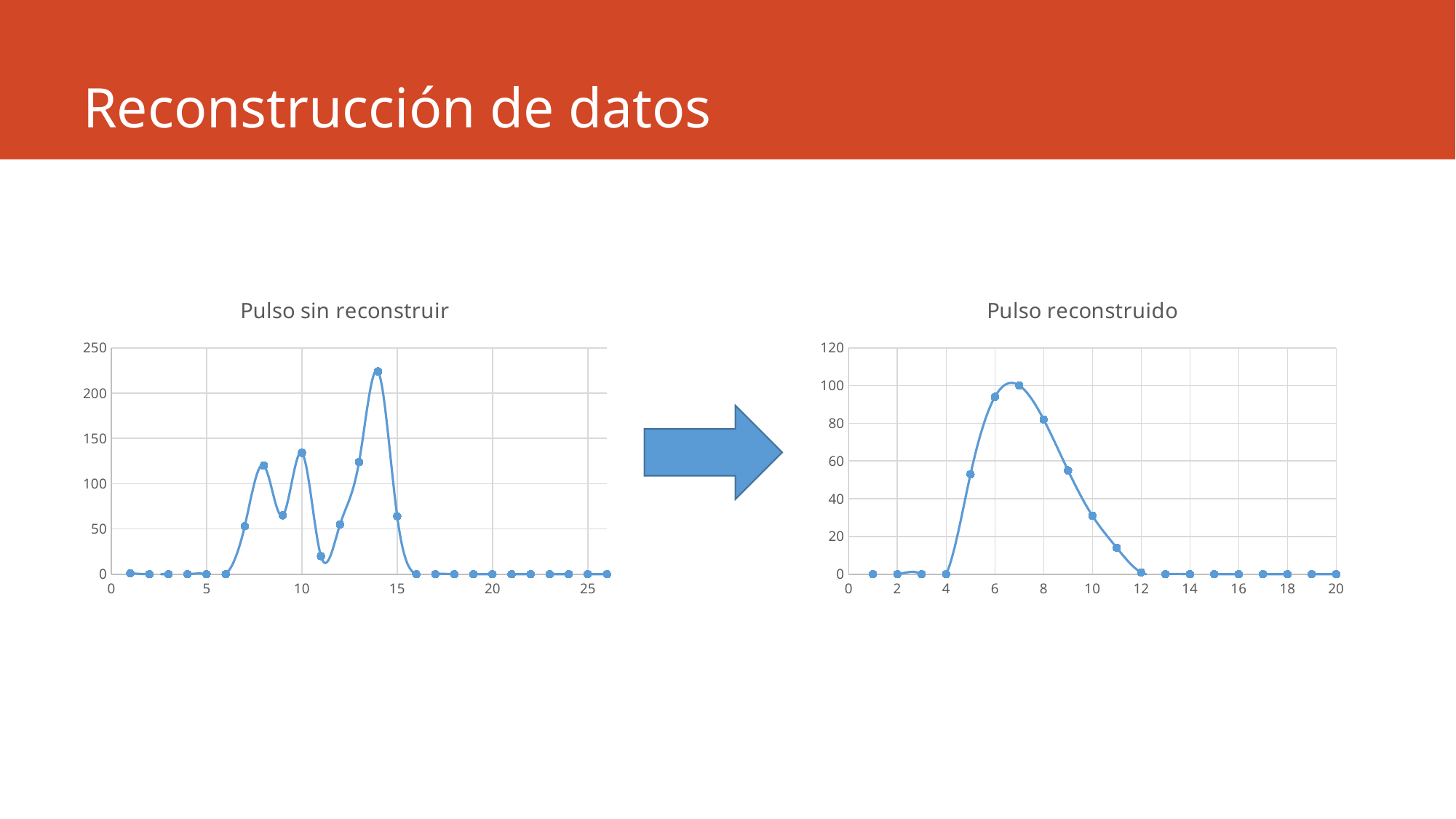
How many data points are plotted in the 'Pulso sin reconstruir' chart? 26 What is the title of the chart on the right side of the slide? Pulso reconstruido In the 'Pulso sin reconstruir' chart, is the value at x = 11 greater or less than 50? less In the 'Pulso sin reconstruir' chart, is the value at x = 14 greater or less than 200? greater What kind of chart is the 'Pulso sin reconstruir' chart? line chart In the 'Pulso sin reconstruir' chart, which is larger, the value at x = 10 or the value at x = 14? x = 14 In the 'Pulso reconstruido' chart, which is larger, the value at x = 6 or the value at x = 9? x = 6 In the 'Pulso reconstruido' chart, at which x value does the line reach its highest point? 7 How many data points are plotted in the 'Pulso reconstruido' chart? 20 In the 'Pulso reconstruido' chart, is the value at x = 11 greater or less than 20? less In the 'Pulso sin reconstruir' chart, at which x value does the line reach its highest point? 14